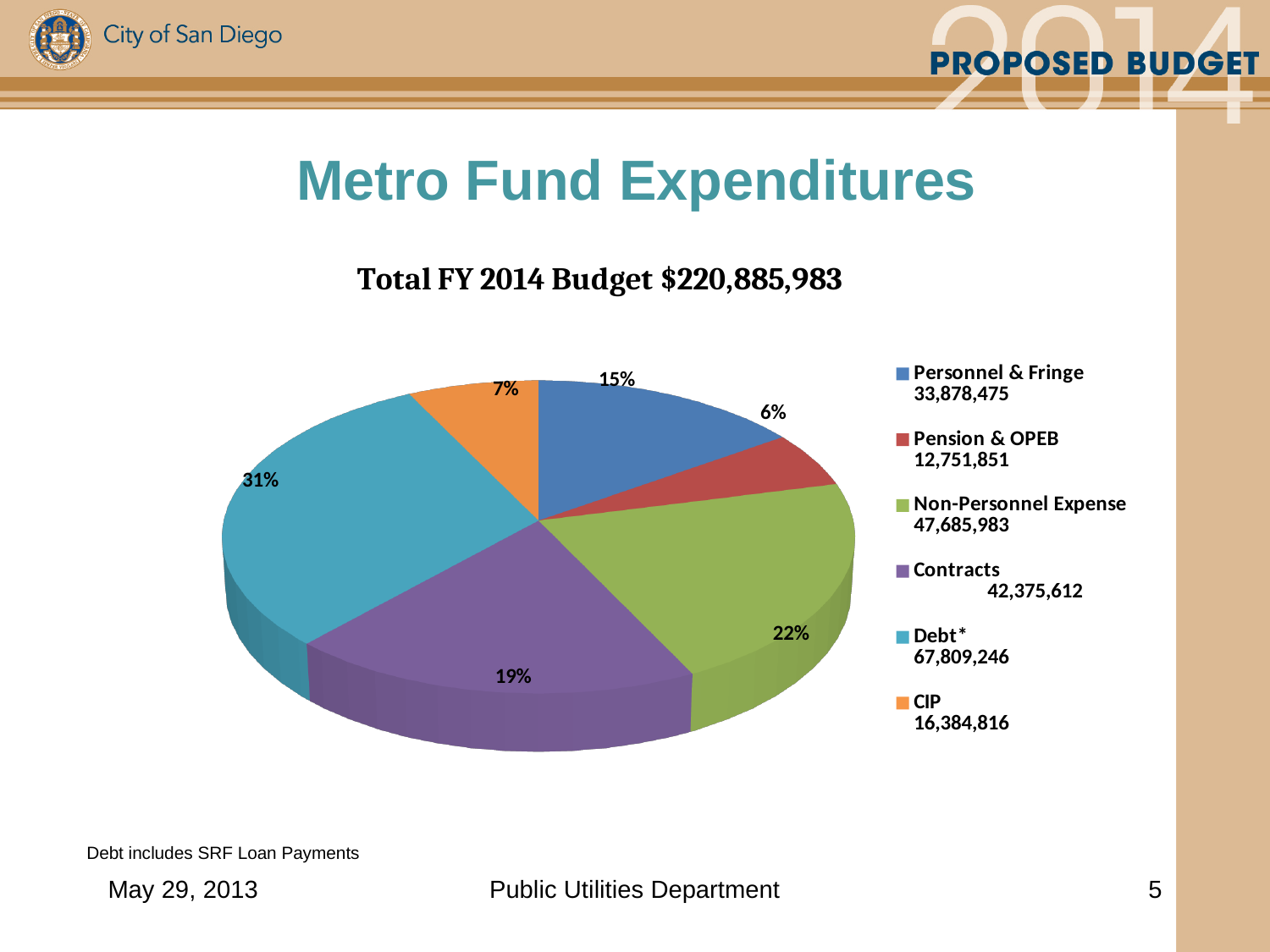
What is the dollar value shown in the legend for Contracts? 42,375,612 What is the difference in percentage points between the Debt* share and the CIP share? 24 What percentage of Metro Fund expenditures is Debt*? 31% Which category has the smallest share of the pie? Pension & OPEB How many categories does the pie chart have? 6 Which is larger, the share for Non-Personnel Expense or the share for Contracts? Non-Personnel Expense What percentage of the pie does Personnel & Fringe represent? 15% What total FY 2014 budget is stated above the chart? $220,885,983 What colour is the Debt* slice in the pie chart? Teal Which category has the largest share of the pie? Debt* What is the dollar value shown in the legend for CIP? 16,384,816 What kind of chart is shown on the slide? Pie chart